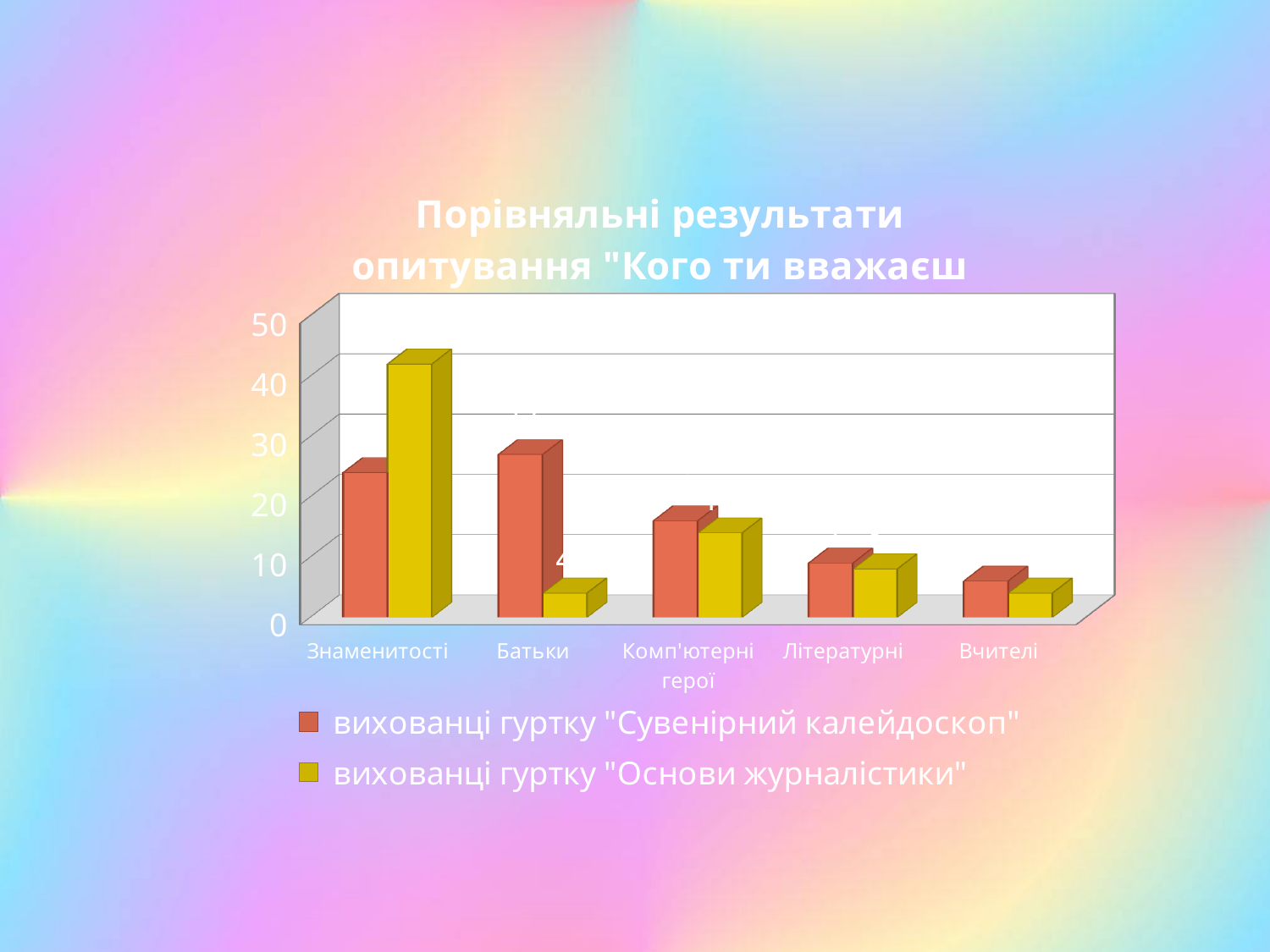
What kind of chart is shown on the slide? bar chart How many series does the chart's legend list? 2 Is the value for Вчителі in the series вихованці гуртку "Сувенірний калейдоскоп" greater or less than 10? less Which category has the lowest value for the series вихованці гуртку "Сувенірний калейдоскоп"? Вчителі Which category has the highest value for the series вихованці гуртку "Основи журналістики"? Знаменитості Is the value for Батьки in the series вихованці гуртку "Основи журналістики" greater or less than 10? less Is the value for Знаменитості in the series вихованці гуртку "Основи журналістики" greater or less than 40? greater How many categories are shown on the x axis of the chart? 5 For Знаменитості, which series has the larger value: вихованці гуртку "Сувенірний калейдоскоп" or вихованці гуртку "Основи журналістики"? вихованці гуртку "Основи журналістики" For Батьки, which series has the larger value: вихованці гуртку "Сувенірний калейдоскоп" or вихованці гуртку "Основи журналістики"? вихованці гуртку "Сувенірний калейдоскоп" What is the name of the series shown with the yellow bars? вихованці гуртку "Основи журналістики"